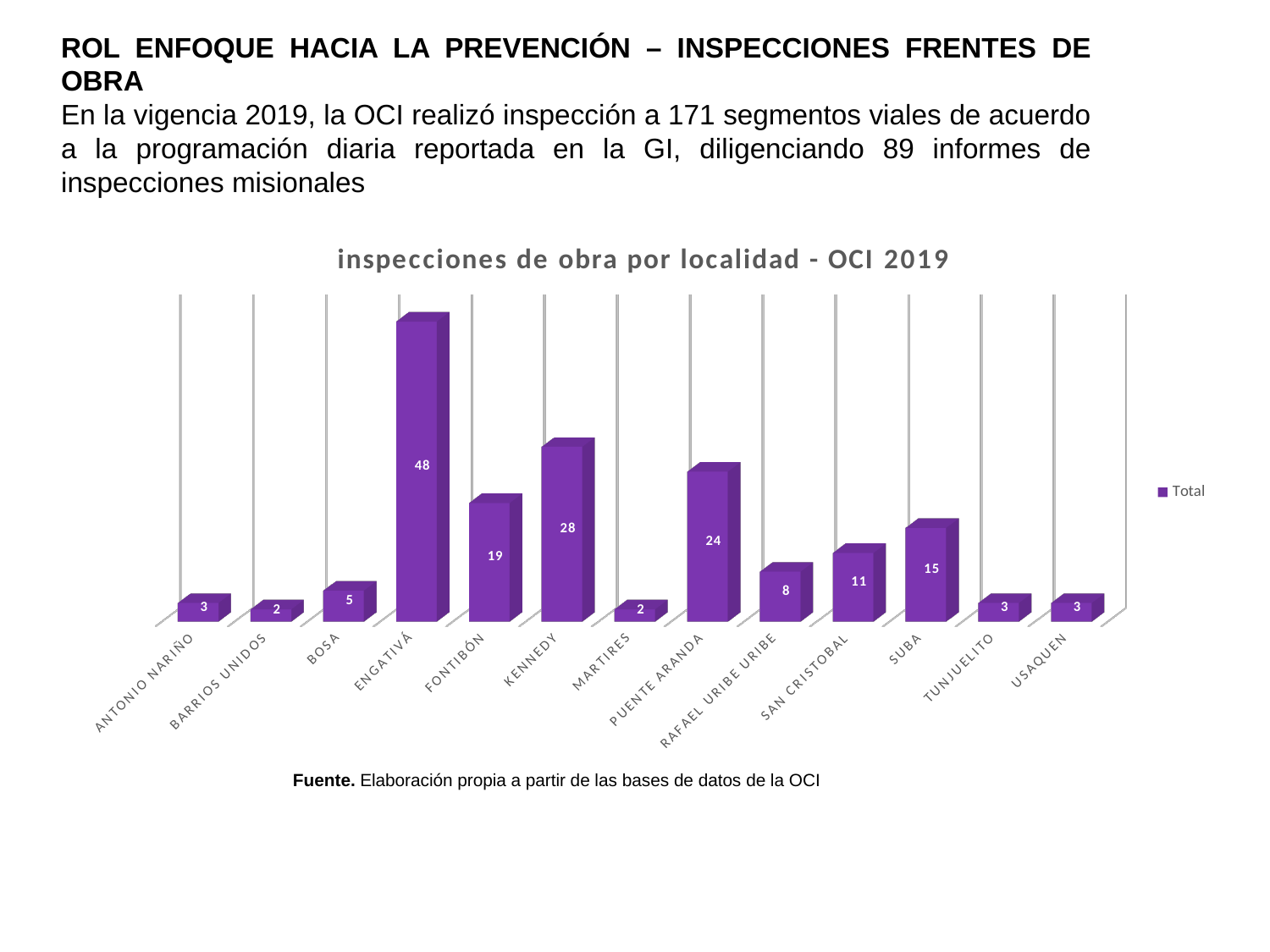
How many series does the legend list? 1 Which is larger, the value for PUENTE ARANDA or the value for FONTIBÓN? PUENTE ARANDA How many localities are shown on the x axis? 13 What is the name of the series in the legend? Total What is the title of the chart? inspecciones de obra por localidad - OCI 2019 Which localities have the lowest value on the chart? BARRIOS UNIDOS and MARTIRES What is the value for KENNEDY? 28 What is the difference between the values for ENGATIVÁ and KENNEDY? 20 What is the value for SAN CRISTOBAL? 11 What is the value for ENGATIVÁ? 48 Which locality has the highest number of inspections? ENGATIVÁ What kind of chart is shown on the slide? Bar chart